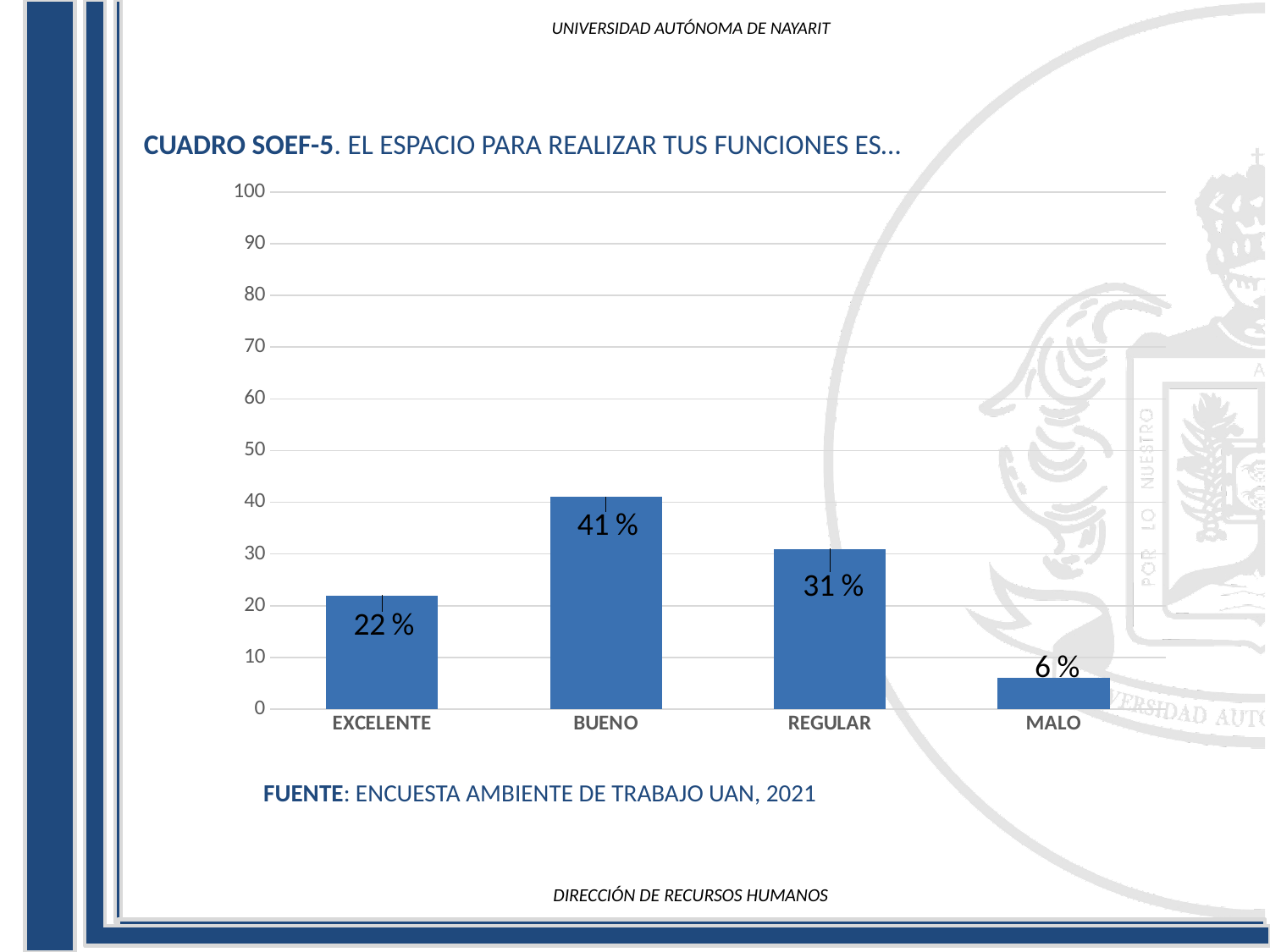
Is the value for REGULAR greater or less than 40? less What kind of chart is shown on the slide? bar chart What is the value for REGULAR? 31 % Which category has the highest value? BUENO What is the value for EXCELENTE? 22 % What is the value for MALO? 6 % Which category has the lowest value? MALO What is the source cited below the chart? ENCUESTA AMBIENTE DE TRABAJO UAN, 2021 Which is larger, the value for EXCELENTE or the value for REGULAR? REGULAR What is the value for BUENO? 41 % What is the difference between the values for BUENO and REGULAR? 10 % How many categories are shown on the x axis? 4